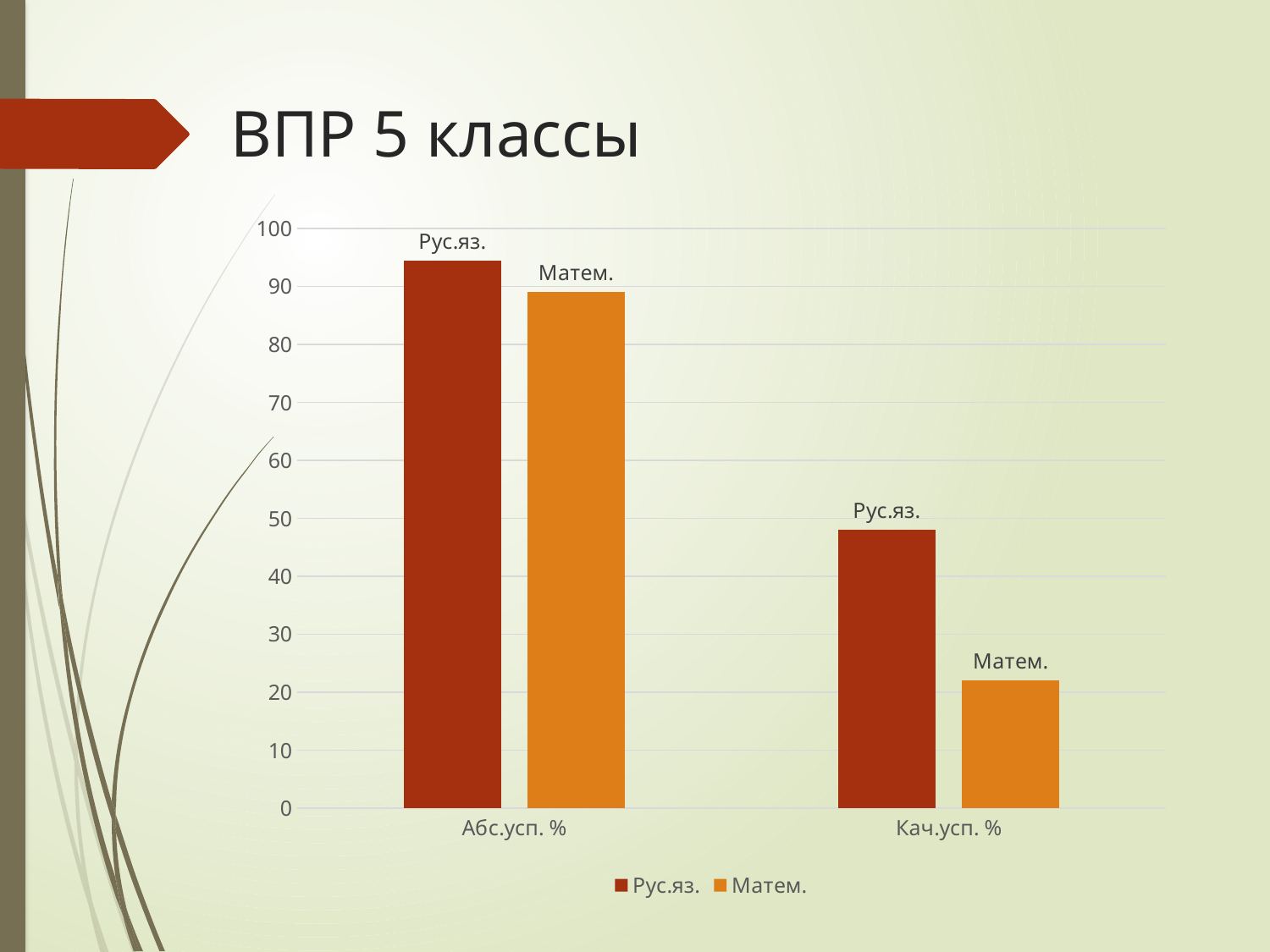
Which series does the legend show in dark red? Рус.яз. Which bar is the tallest in the chart? Рус.яз. in Абс.усп. % Is the value for Матем. in Абс.усп. % greater or less than 80? greater Which bar is the shortest in the chart? Матем. in Кач.усп. % Is the value for Матем. in Кач.усп. % greater or less than 30? less How many series does the legend list? 2 In the Кач.усп. % category, which is larger: Рус.яз. or Матем.? Рус.яз. What kind of chart is shown on the slide? bar chart In the Абс.усп. % category, which is larger: Рус.яз. or Матем.? Рус.яз. Is the value for Рус.яз. in Абс.усп. % greater or less than 90? greater How many categories are shown on the x axis? 2 What is the title of the slide with the chart? ВПР 5 классы